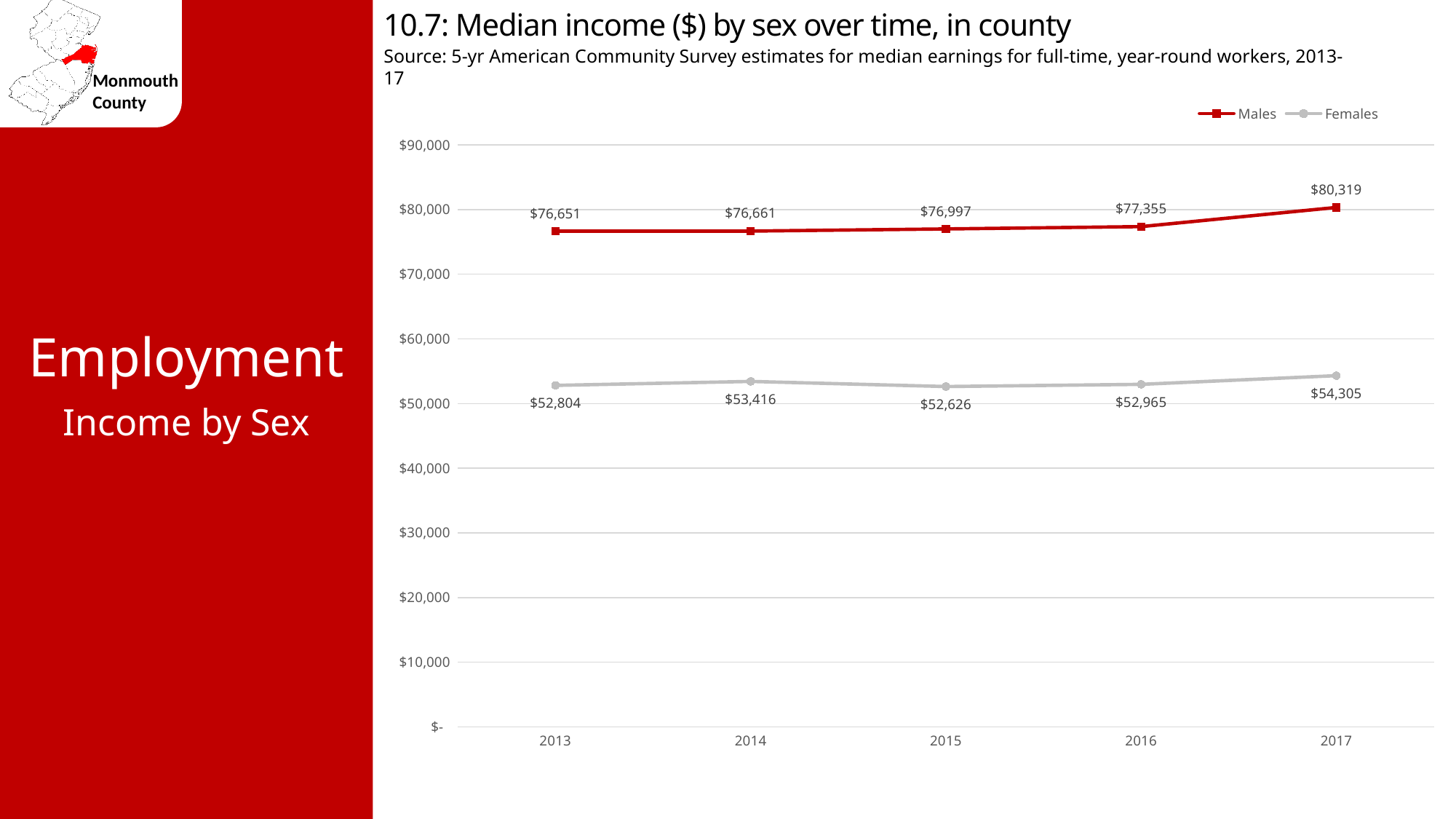
In which year is the Females median income lowest? 2015 What kind of chart is shown on the slide? line chart What is the difference between the Males median income in 2017 and in 2016? $2,964 What is the difference between the Males and Females median income in 2017? $26,014 Which is larger, the Females median income in 2014 or in 2016? 2014 In which year is the Males median income highest? 2017 Is the Males median income in 2017 greater or less than $80,000? greater What is the median income for Females in 2015? $52,626 What is the median income for Males in 2013? $76,651 How many years are shown on the x axis? 5 What is the median income for Males in 2017? $80,319 How many series does the legend list? 2